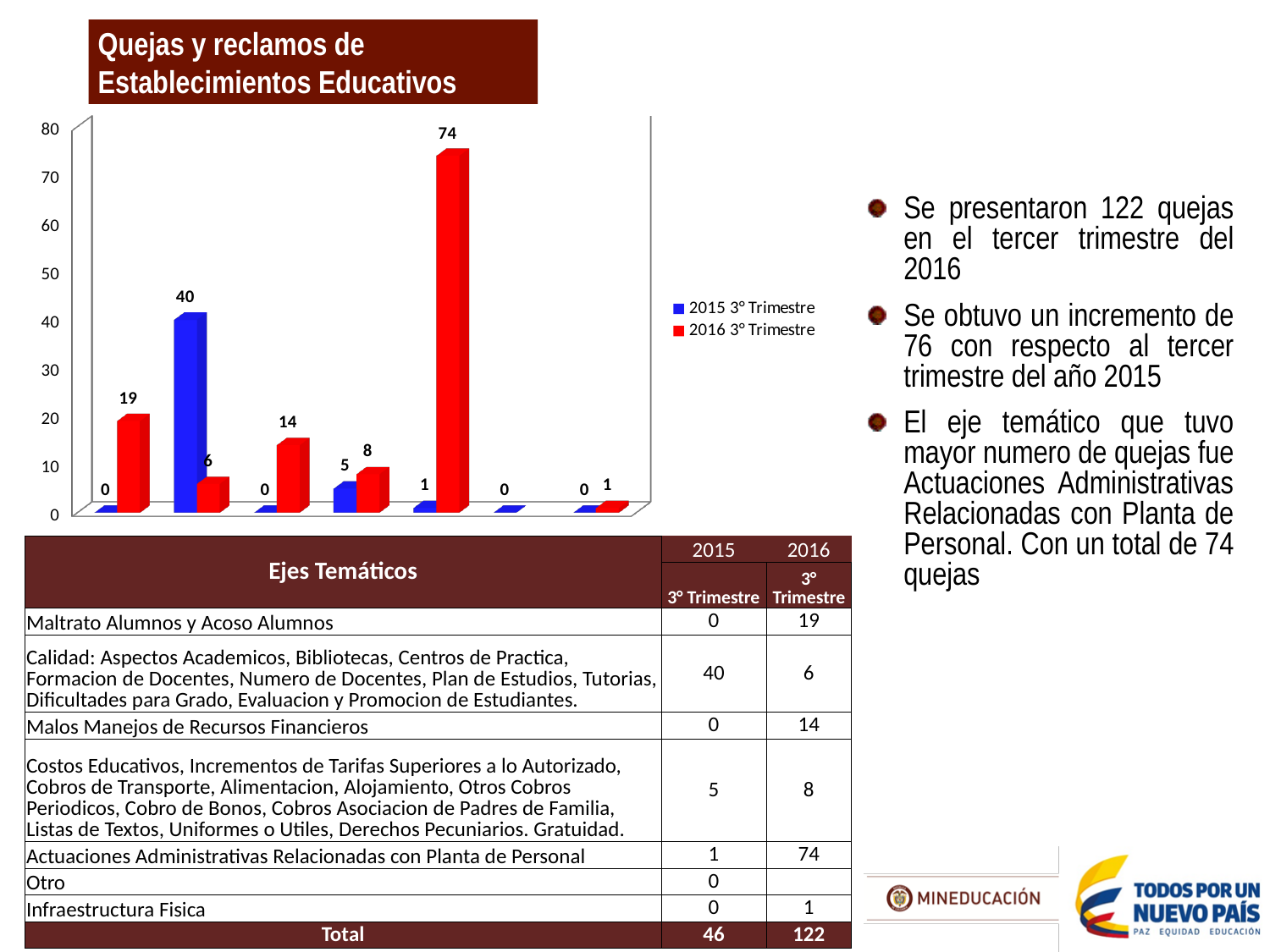
For the second category (Calidad), which series has the larger value, 2015 3° Trimestre or 2016 3° Trimestre? 2015 3° Trimestre What is the highest value shown in the chart for the 2016 3° Trimestre series? 74 Which colour represents the 2016 3° Trimestre series in the chart? red What are the two series named in the chart legend? 2015 3° Trimestre and 2016 3° Trimestre What type of chart is shown on the slide? bar chart What is the difference between the 2016 and 2015 3° Trimestre values for Actuaciones Administrativas Relacionadas con Planta de Personal (74 and 1)? 73 Is the tallest bar in the chart greater or less than 70? greater What is the 2016 3° Trimestre value for the first category (Maltrato Alumnos y Acoso Alumnos)? 19 What is the highest value shown in the chart for the 2015 3° Trimestre series? 40 How many series does the chart legend list? 2 What is the 2016 3° Trimestre value for the third category (Malos Manejos de Recursos Financieros)? 14 What is the 2015 3° Trimestre value for the second category (Calidad: Aspectos Academicos...)? 40